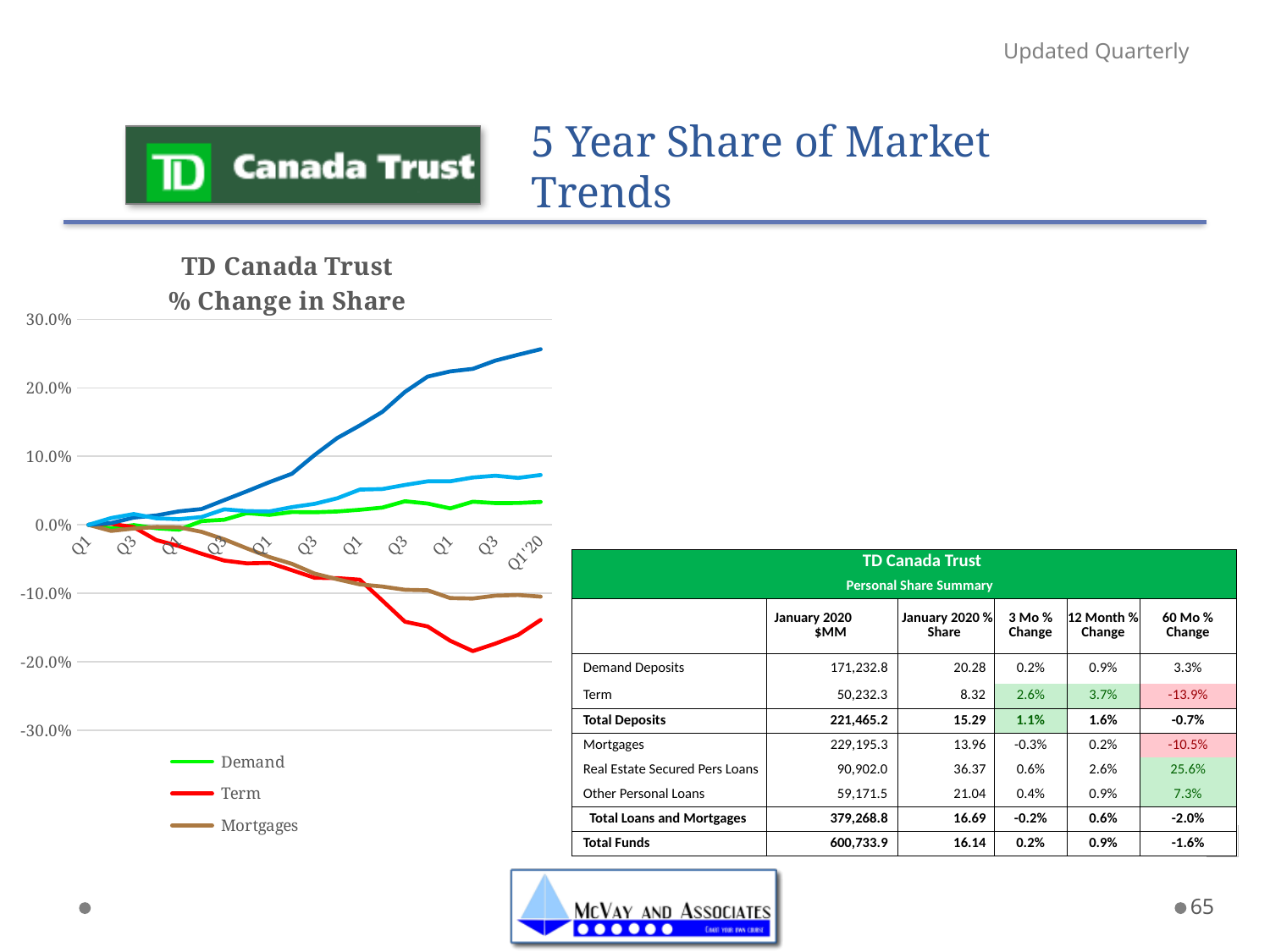
Is the value for Demand at Q1'20 greater or less than 0.0%? greater What kind of chart is shown on the slide? line chart Is the value for Term at Q1'20 greater or less than -20.0%? greater Is the lowest point of the Term line greater or less than -10.0%? less Of the series listed in the legend, which has the lowest value at Q1'20? Term What is the title of the chart? TD Canada Trust % Change in Share What colour is the Term line in the chart? red At Q1'20, which is larger, the value for Demand or the value for Term? Demand Does the Term line generally rise or fall from Q1 to Q1'20? fall How many series does the chart legend list? 3